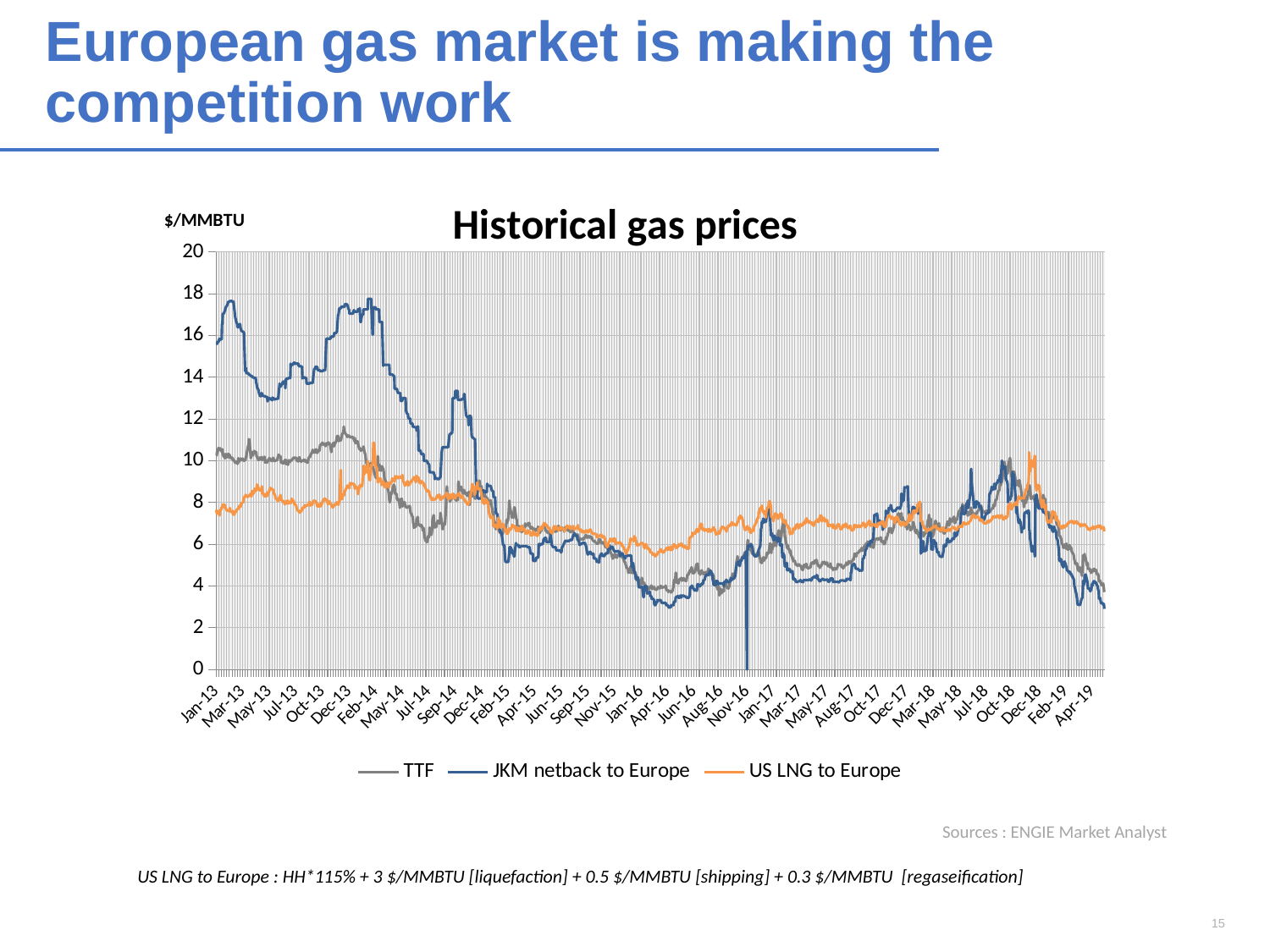
How many series does the legend of the chart list? 3 Is the value of JKM netback to Europe in Jan-13 greater or less than 14? greater Does the JKM netback to Europe series overall rise or fall from Jan-13 to Apr-19? Fall What is the title of the chart? Historical gas prices Is the value of US LNG to Europe in Jan-13 greater or less than 10? less Which series has the highest value in Jan-13? JKM netback to Europe In Apr-16, which is larger: US LNG to Europe or JKM netback to Europe? US LNG to Europe Which series has the lowest value in Apr-16? JKM netback to Europe Is the value of TTF in Mar-17 greater or less than 6? less What unit is shown on the vertical axis of the chart? $/MMBTU What kind of chart is shown on the slide? Line chart